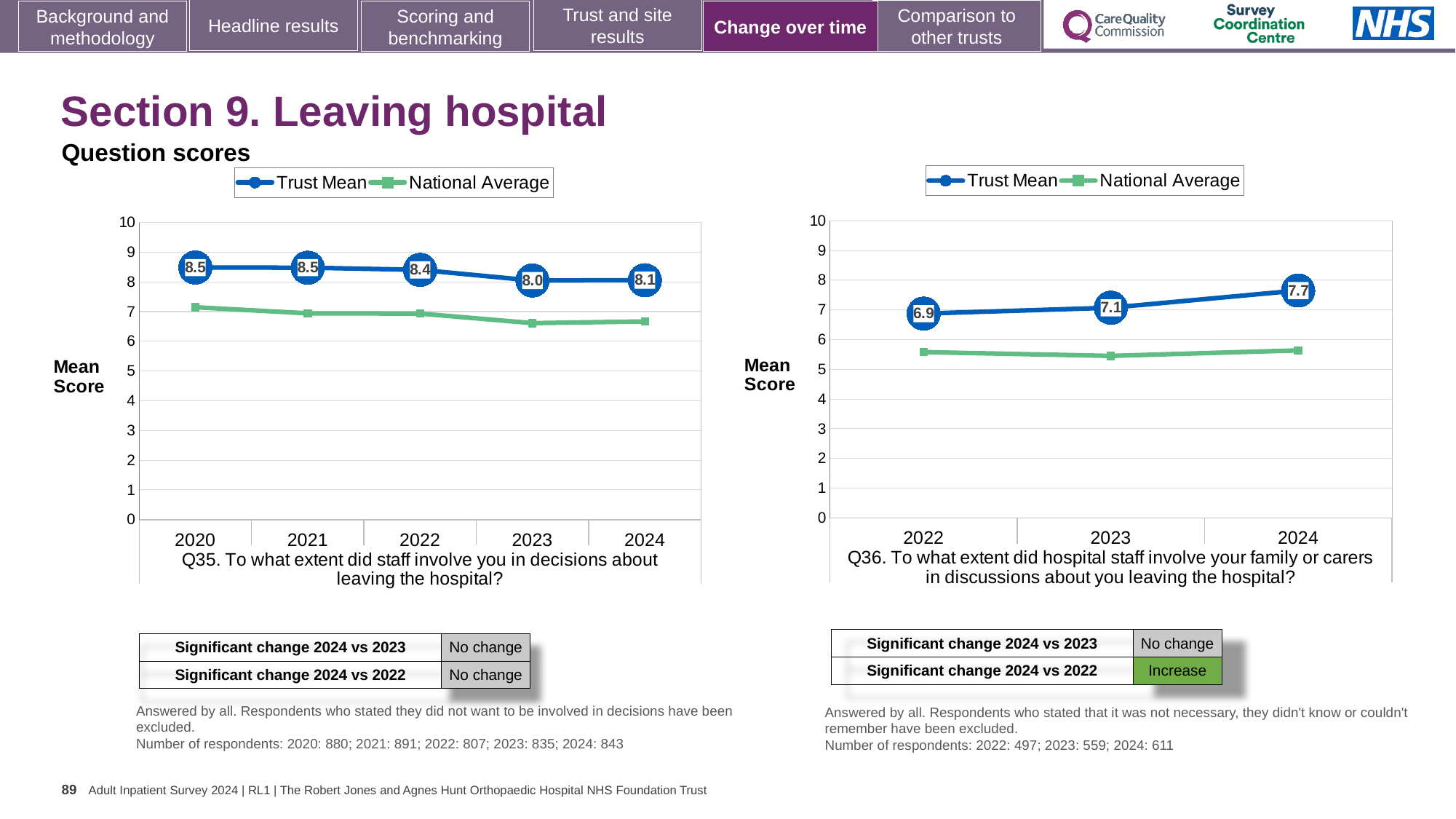
How many series does the legend of the Q36 chart on the right list? 2 In the Q36 chart on the right, which year has the highest Trust Mean score? 2024 In the Q35 chart on the left, what is the Trust Mean score for 2020? 8.5 In the Q36 chart on the right, what is the difference between the Trust Mean scores for 2024 and 2022? 0.8 In the Q36 chart on the right, does the Trust Mean rise or fall from 2022 to 2024? rise In the Q35 chart on the left, is the National Average value for 2023 greater or less than 7? less In the Q35 chart on the left, what is the difference between the Trust Mean scores for 2020 and 2024? 0.4 In the Q35 chart on the left, how many years are plotted on the x axis? 5 In the Q35 chart on the left, which year has the lowest Trust Mean score? 2023 In the Q36 chart on the right, is the National Average value for 2022 greater or less than 6? less In the Q36 chart on the right, what is the Trust Mean score for 2024? 7.7 In the Q35 chart on the left, what is the Trust Mean score for 2023? 8.0